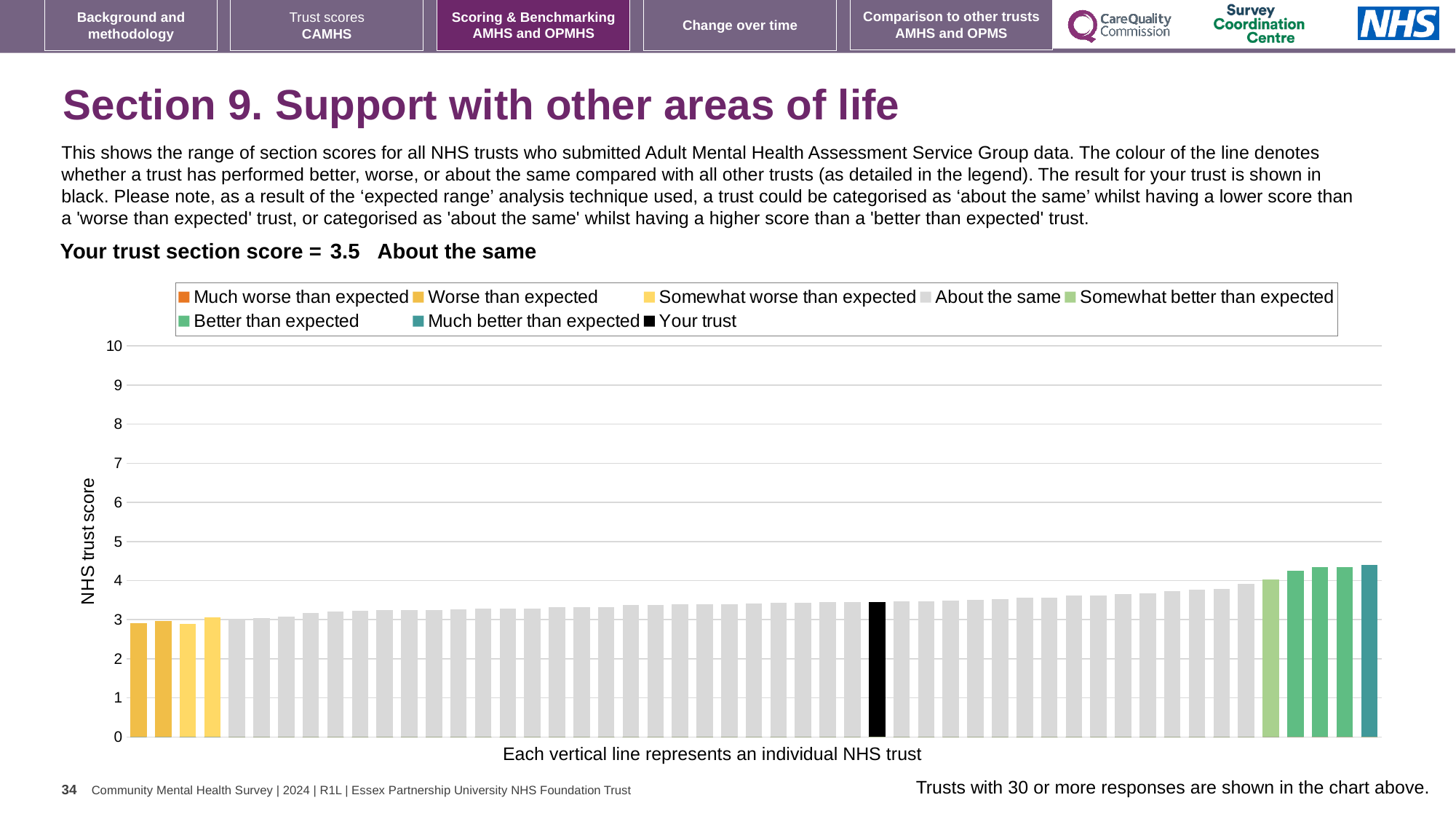
What colour is the bar representing your trust? black Is the value for your trust greater or less than 3? greater What kind of chart is shown on the slide? bar chart Is the highest bar in the chart greater or less than 4? greater Do the bar values rise or fall from left to right along the x axis? rise Is the value for your trust greater or less than 5? less What is the section score for your trust shown on the slide? 3.5 Which category is your trust's section score placed in? About the same What is the label on the y axis of the chart? NHS trust score How many entries does the chart legend list? 8